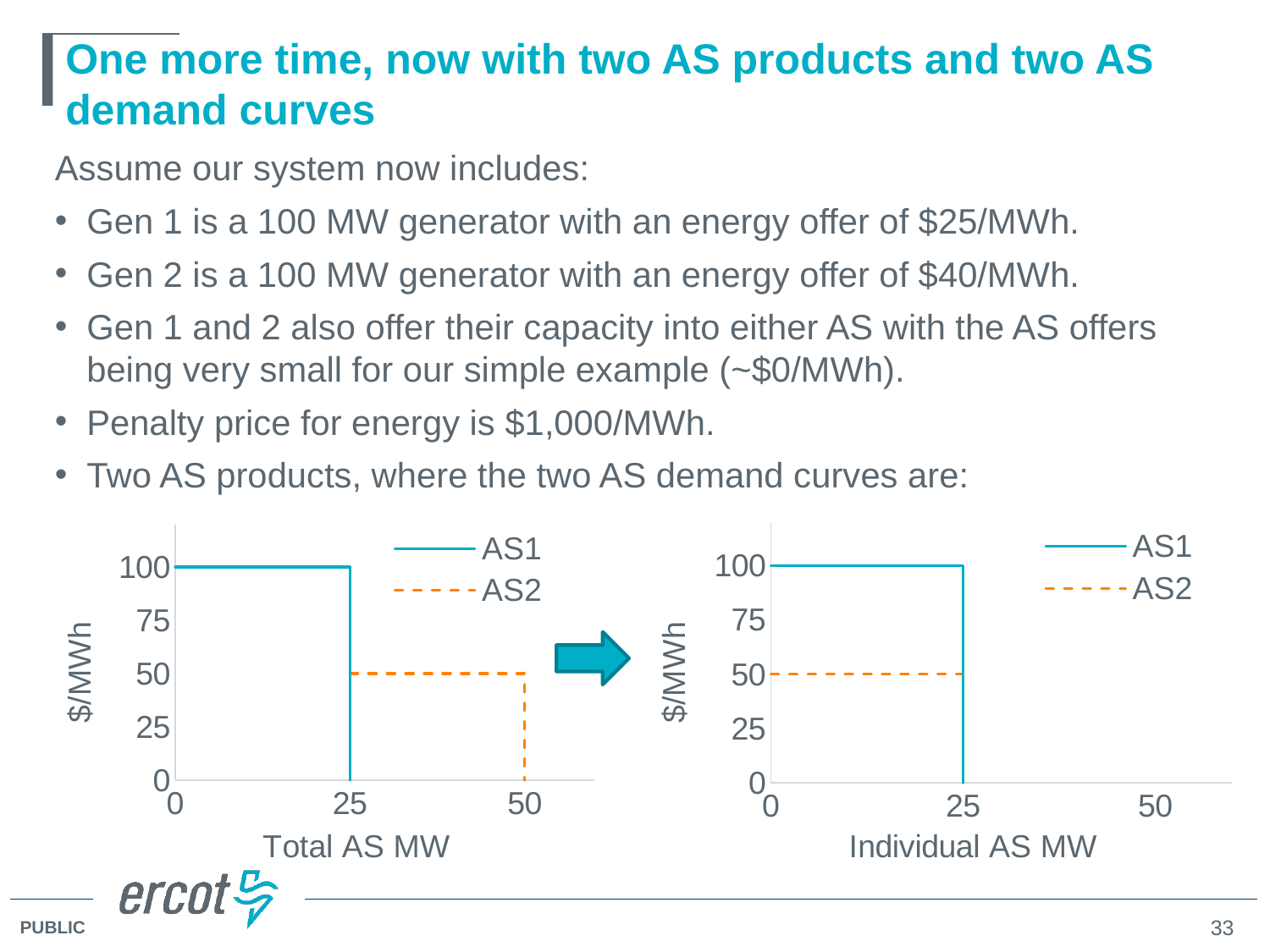
In the right chart (Individual AS MW), which series has the higher $/MWh level, AS1 or AS2? AS1 In the left chart (Total AS MW), at what Total AS MW value does the AS1 curve drop to 0? 25 What kind of chart is the left chart (Total AS MW)? Line chart In the left chart (Total AS MW), is the AS2 price level greater or less than 75 $/MWh? less What is the x-axis label of the right chart? Individual AS MW In the right chart (Individual AS MW), what are the two legend entries? AS1 and AS2 In the right chart (Individual AS MW), at what Individual AS MW value does the AS1 curve drop to 0? 25 In the left chart (Total AS MW), what is the $/MWh level of the AS1 demand curve? 100 In the left chart (Total AS MW), what is the difference in $/MWh between the AS1 level and the AS2 level? 50 In the left chart (Total AS MW), how many series does the legend list? 2 In the left chart (Total AS MW), at what Total AS MW value does the AS2 curve drop to 0? 50 In the left chart (Total AS MW), what is the $/MWh level of the AS2 demand curve? 50